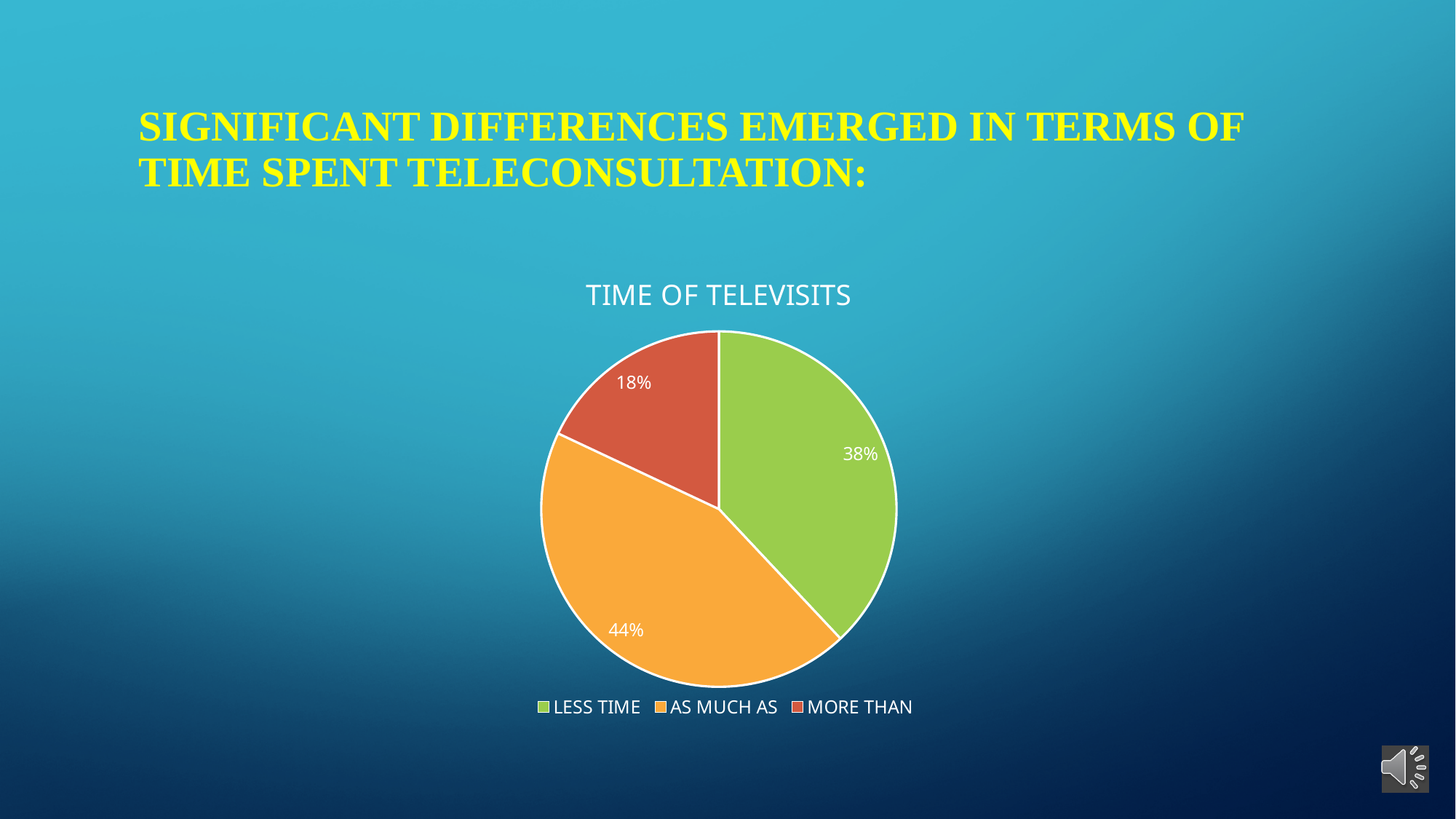
What percentage of the pie is labelled LESS TIME? 38% How many slices does the pie chart have? 3 How many entries does the legend list? 3 Which is larger, the share for LESS TIME or the share for MORE THAN? LESS TIME What colour is the slice for MORE THAN? red What is the difference in percentage points between AS MUCH AS and MORE THAN? 26 What percentage of the pie is labelled MORE THAN? 18% Which category has the smallest share of the pie? MORE THAN What percentage of the pie is labelled AS MUCH AS? 44% What type of chart is shown on the slide? pie chart What is the title of the chart? TIME OF TELEVISITS Which category has the largest share of the pie? AS MUCH AS